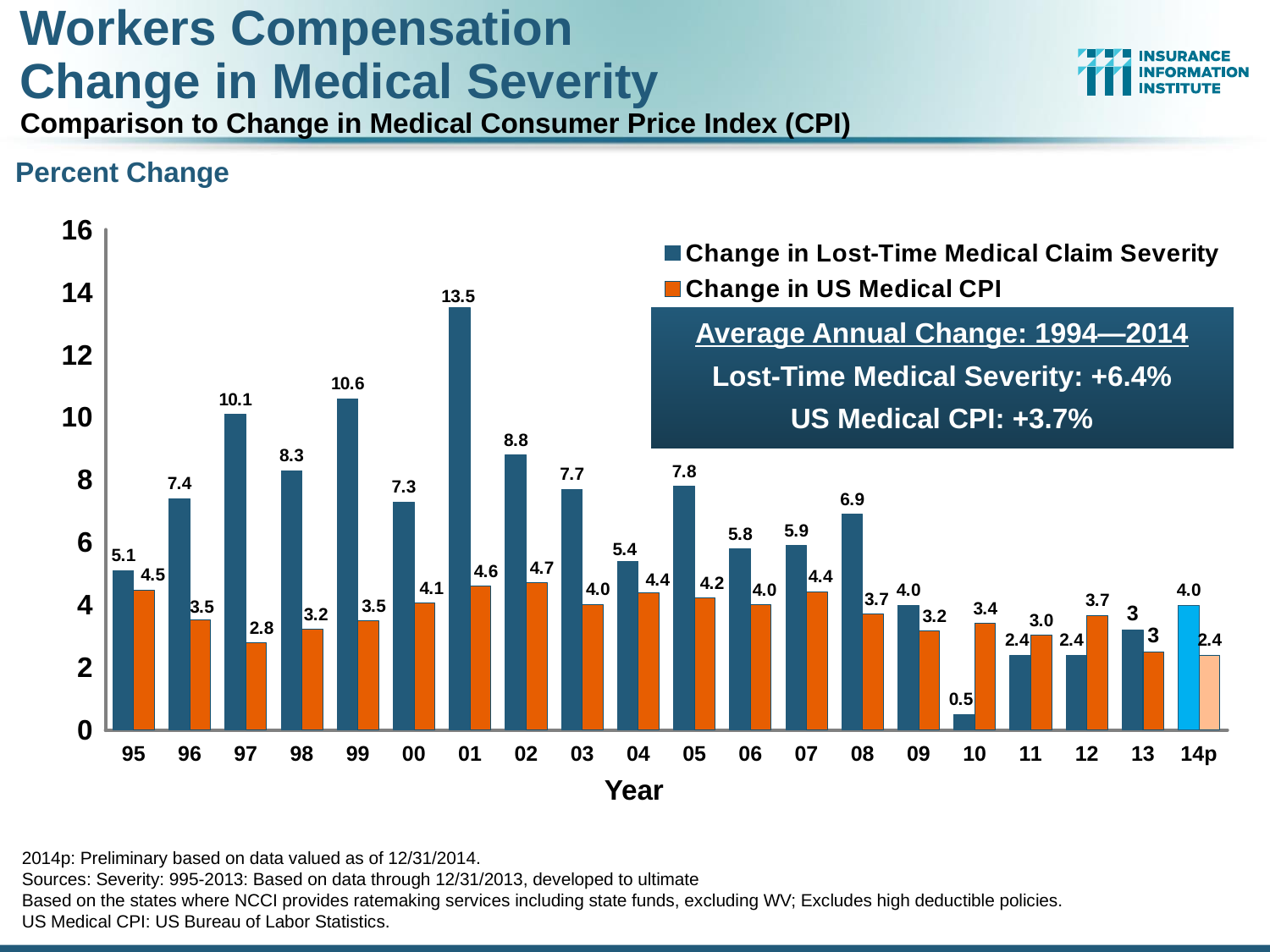
How many years are shown on the x axis? 20 What is the difference between the Change in Lost-Time Medical Claim Severity and the Change in US Medical CPI in 01? 8.9 What is the Change in US Medical CPI for 02? 4.7 Which year has the lowest Change in Lost-Time Medical Claim Severity? 10 Does the Change in Lost-Time Medical Claim Severity rise or fall from 08 to 10? Fall What is the Change in Lost-Time Medical Claim Severity for 14p? 4.0 According to the text box on the chart, what is the average annual change in US Medical CPI for 1994—2014? +3.7% In 10, which is larger: the Change in Lost-Time Medical Claim Severity or the Change in US Medical CPI? Change in US Medical CPI What kind of chart is shown on the slide? Bar chart Which year has the highest Change in Lost-Time Medical Claim Severity? 01 How many series does the legend list? 2 What is the Change in Lost-Time Medical Claim Severity for 01? 13.5